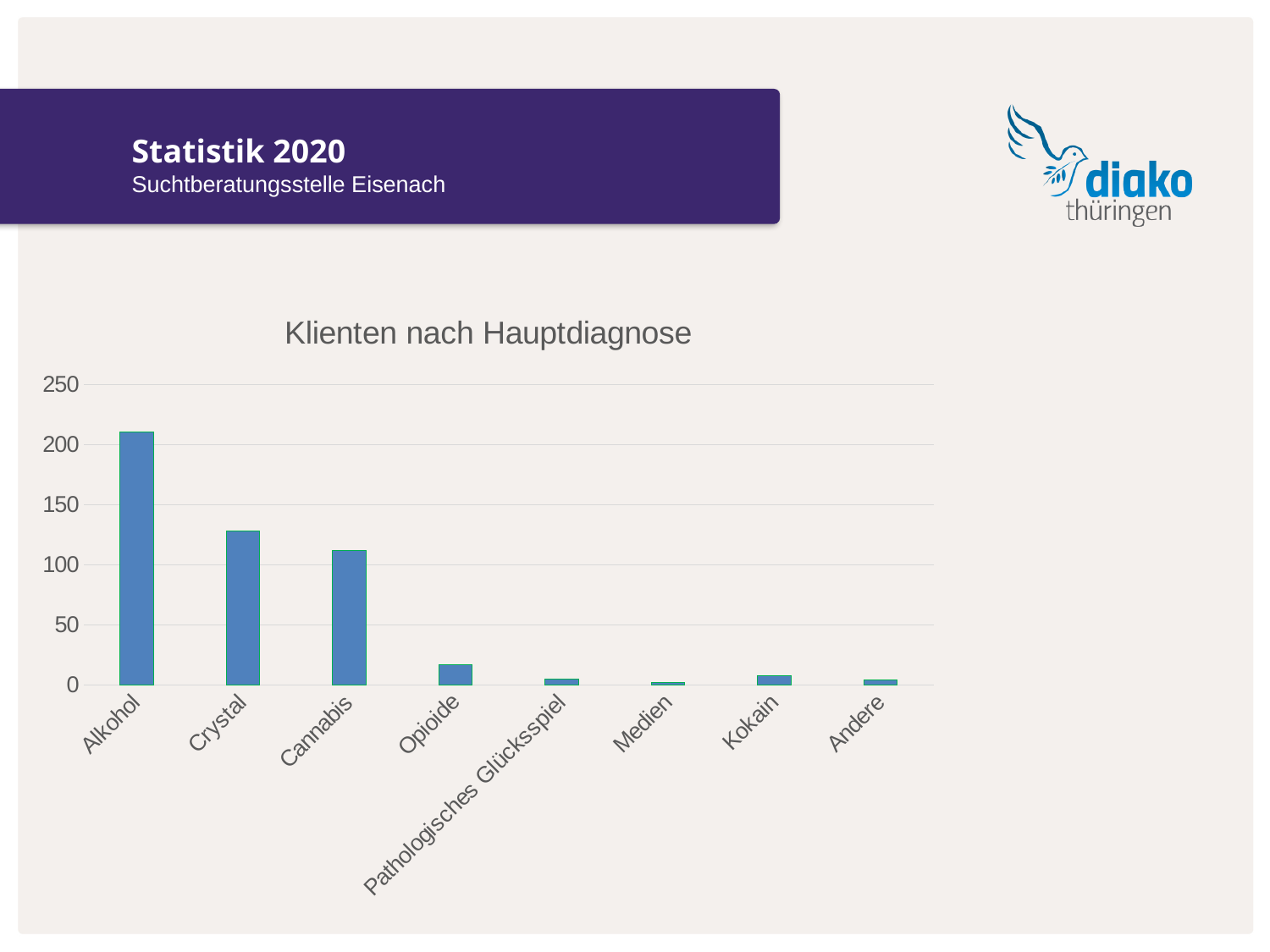
Is the value for Opioide greater or less than 50? less Which is larger, the value for Crystal or the value for Cannabis? Crystal Is the value for Crystal greater or less than 100? greater How many categories are shown on the x axis of the chart? 8 Which is larger, the value for Alkohol or the value for Crystal? Alkohol What is the title of the chart? Klienten nach Hauptdiagnose Is the value for Crystal greater or less than 150? less Which is larger, the value for Opioide or the value for Kokain? Opioide Which category has the highest value in the chart? Alkohol What kind of chart is shown on the slide? bar chart